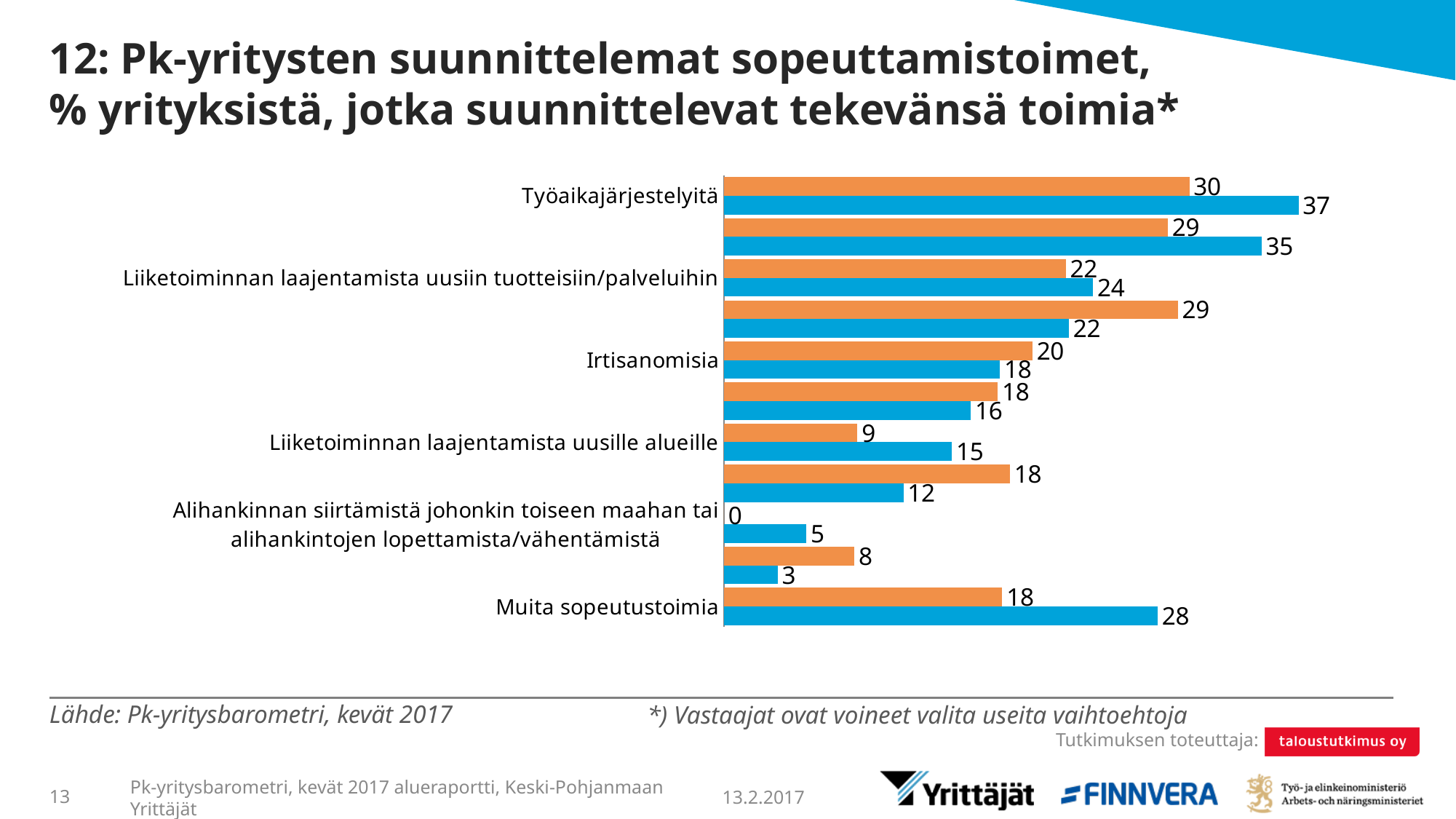
What is the value of the orange bar for Alihankinnan siirtämistä johonkin toiseen maahan tai alihankintojen lopettamista/vähentämistä? 0 Which labelled category has the lowest orange bar value? Alihankinnan siirtämistä johonkin toiseen maahan tai alihankintojen lopettamista/vähentämistä What is the value of the orange bar for Työaikajärjestelyitä? 30 For Irtisanomisia, which bar is larger, the orange or the blue one? orange What type of chart is shown on the slide? bar chart What is the difference between the blue and orange bar values for Muita sopeutustoimia? 10 What is the value of the blue bar for Työaikajärjestelyitä? 37 What colours are the two bar series in the chart? orange and blue Which labelled category has the highest blue bar value? Työaikajärjestelyitä What is the difference between the blue and orange bar values for Työaikajärjestelyitä? 7 What is the value of the blue bar for Muita sopeutustoimia? 28 What is the value of the orange bar for Liiketoiminnan laajentamista uusille alueille? 9